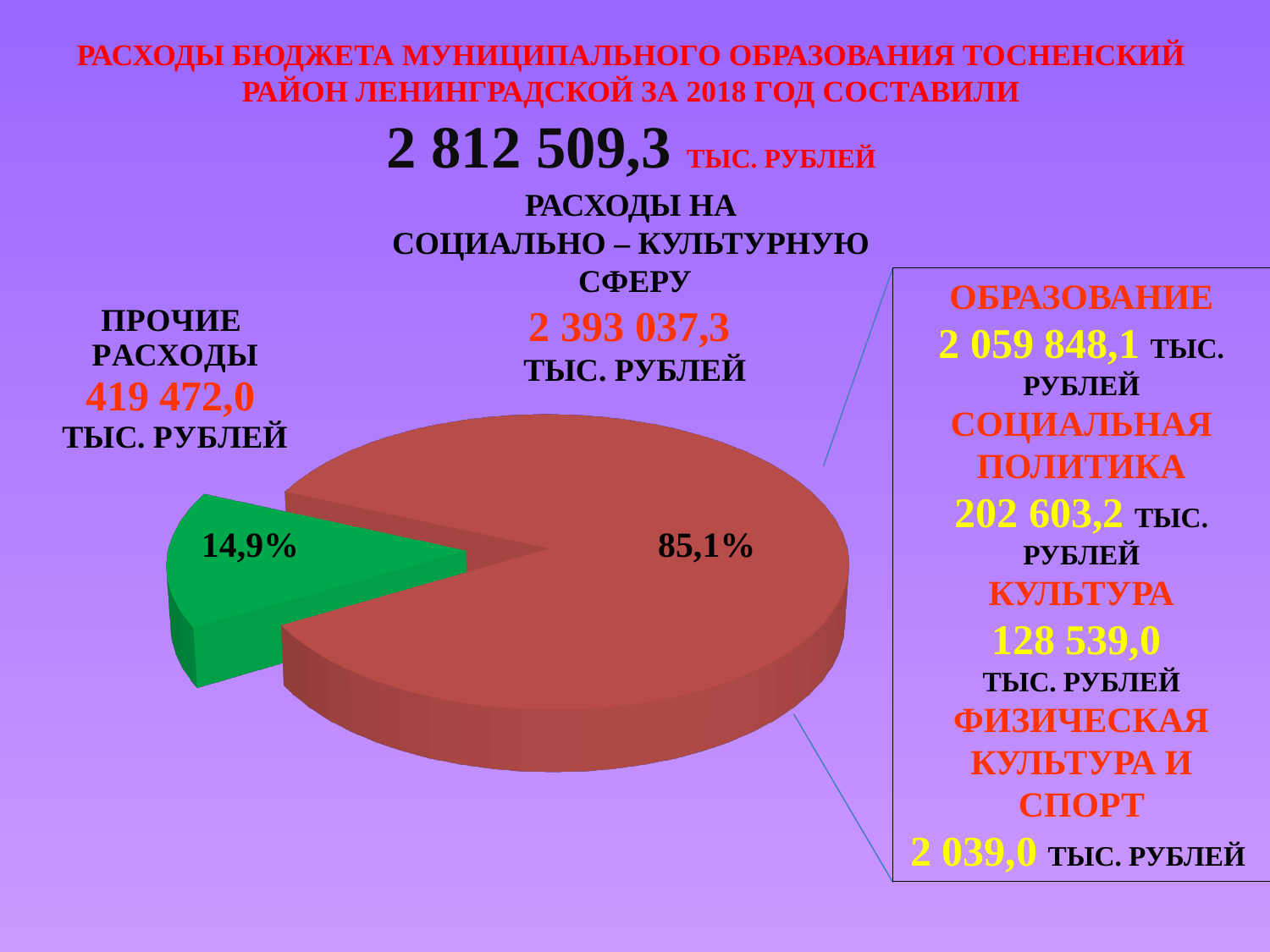
What is the amount shown for ПРОЧИЕ РАСХОДЫ? 419 472,0 тыс. рублей What is the amount shown for РАСХОДЫ НА СОЦИАЛЬНО – КУЛЬТУРНУЮ СФЕРУ? 2 393 037,3 тыс. рублей Which slice of the pie is the smallest? ПРОЧИЕ РАСХОДЫ (14,9%) What kind of chart is shown on the slide? pie chart How many slices does the pie chart have? 2 What is the difference in percentage points between the two slices of the pie? 70,2 What colour is the slice representing ПРОЧИЕ РАСХОДЫ? green What share of the pie is labelled for other expenses (ПРОЧИЕ РАСХОДЫ)? 14,9% What total budget expenditure for 2018 is stated at the top of the slide? 2 812 509,3 тыс. рублей Which slice of the pie is the largest? РАСХОДЫ НА СОЦИАЛЬНО – КУЛЬТУРНУЮ СФЕРУ (85,1%) What amount is shown for ОБРАЗОВАНИЕ in the box on the right? 2 059 848,1 тыс. рублей What share of the pie is labelled for the social-cultural sphere expenses (РАСХОДЫ НА СОЦИАЛЬНО – КУЛЬТУРНУЮ СФЕРУ)? 85,1%